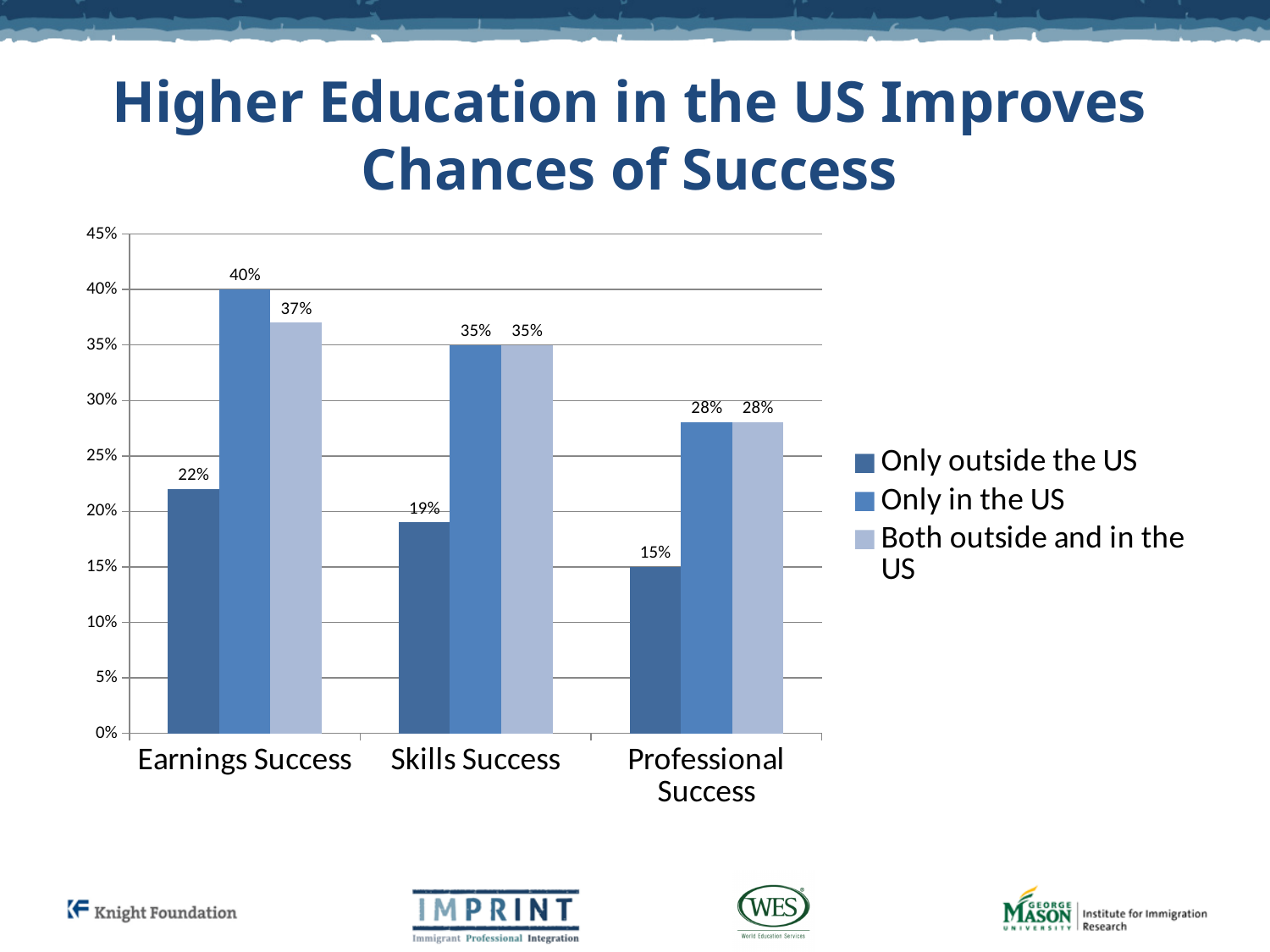
What is the difference between 'Only in the US' and 'Only outside the US' in the Skills Success category? 16% In the Earnings Success category, which is larger: 'Only in the US' or 'Both outside and in the US'? Only in the US What is the value for 'Both outside and in the US' in the Skills Success category? 35% What is the difference between 'Only in the US' and 'Only outside the US' in the Earnings Success category? 18% Which category has the highest value for the 'Only outside the US' series? Earnings Success How many categories are shown on the x axis? 3 What kind of chart is shown on the slide? Bar chart What is the value for 'Only outside the US' in the Professional Success category? 15% Is the value for 'Only outside the US' in the Skills Success category greater or less than 20%? less How many series does the legend list? 3 Which category has the lowest value for the 'Only in the US' series? Professional Success What is the value for 'Only in the US' in the Earnings Success category? 40%